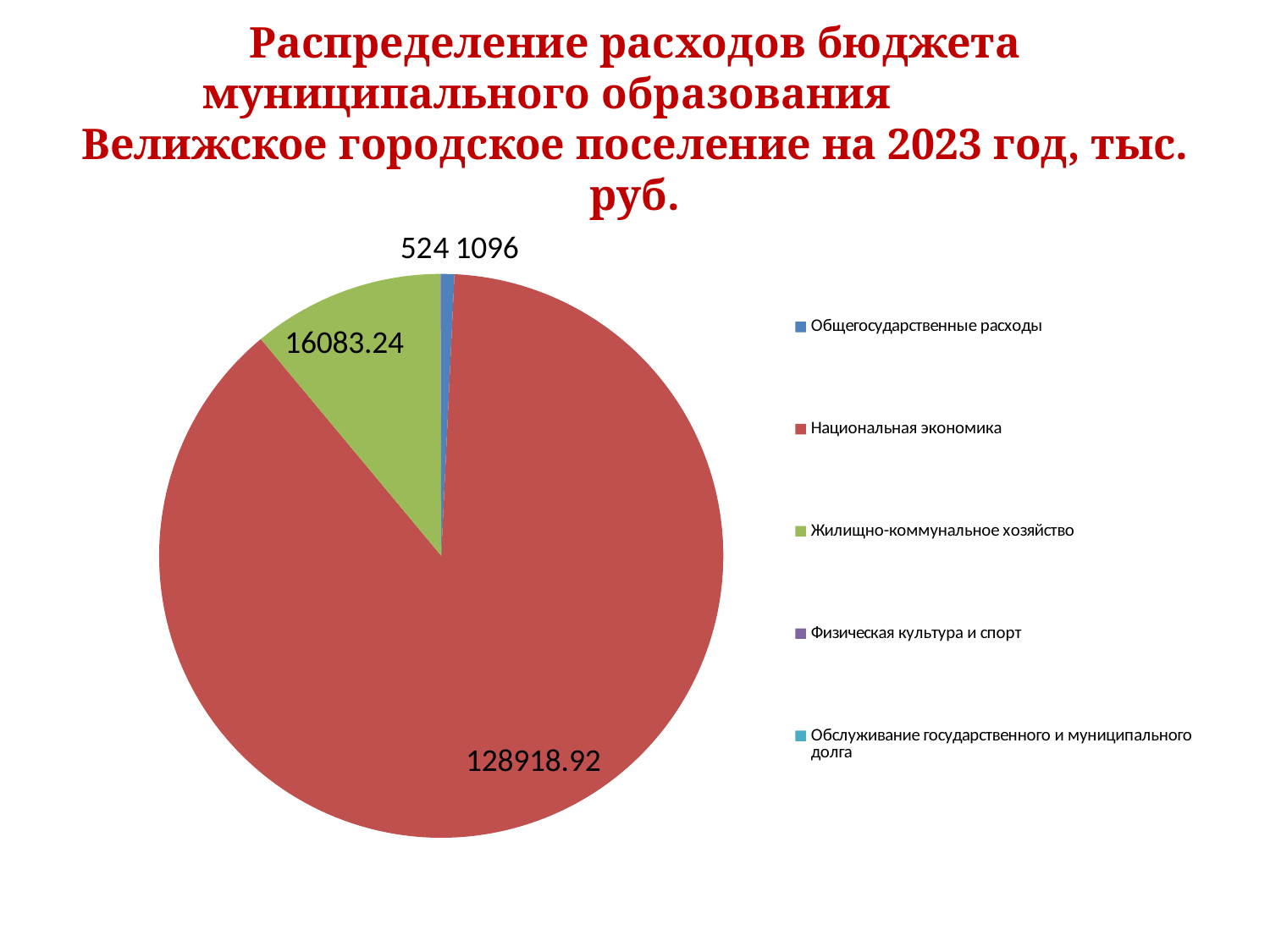
Which is larger, Национальная экономика or Жилищно-коммунальное хозяйство? Национальная экономика What kind of chart is shown on the slide? pie chart Which category is shown in green? Жилищно-коммунальное хозяйство What is the value for Национальная экономика? 128918.92 In what units are the values on the chart given, according to the title? тыс. руб. What is the value for Жилищно-коммунальное хозяйство? 16083.24 What is the difference between the values for Национальная экономика and Жилищно-коммунальное хозяйство? 112835.68 How many categories does the legend list? 5 Which category has the largest slice of the pie? Национальная экономика